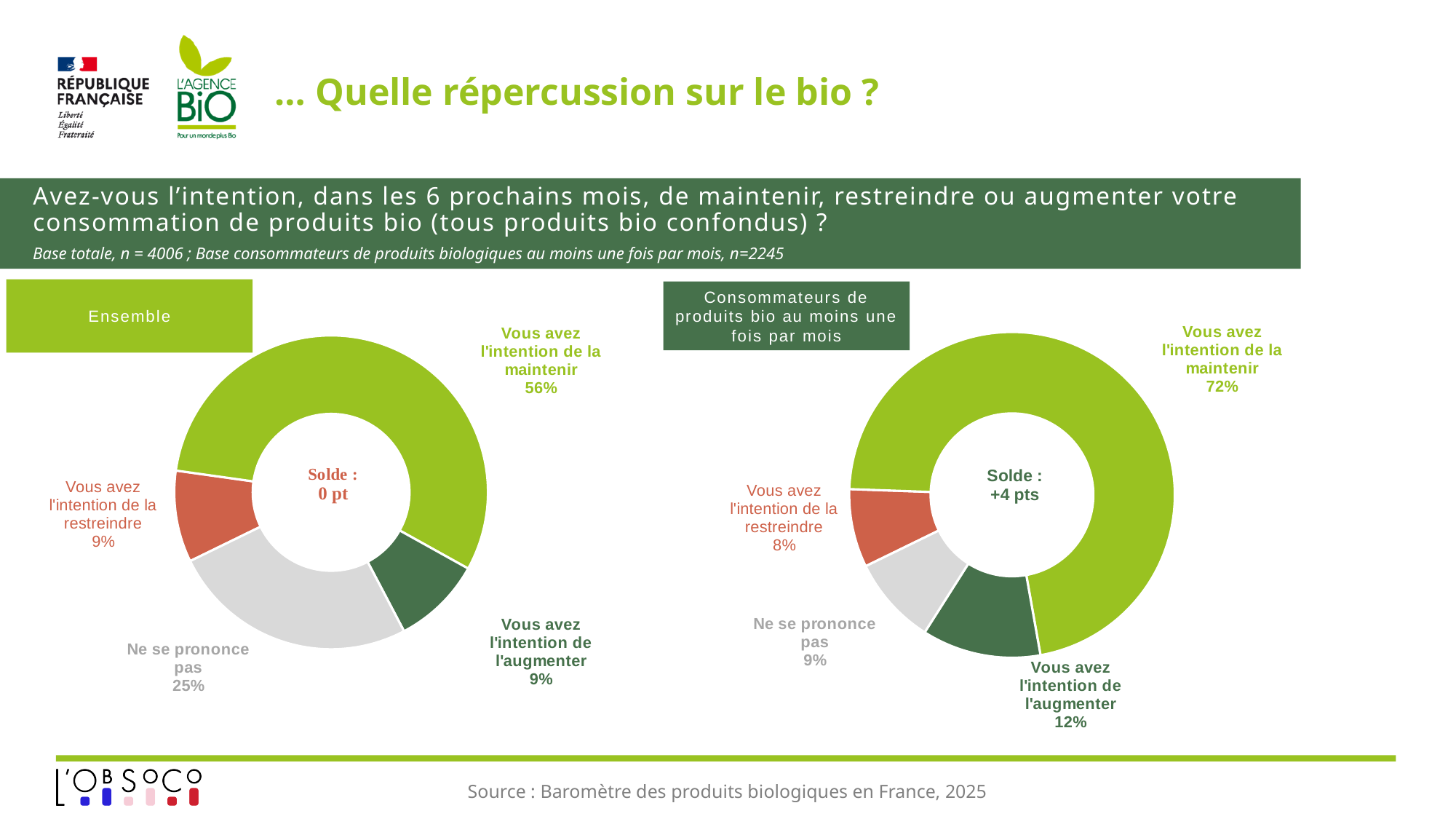
What 'Solde' value is shown in the centre of the 'Ensemble' chart? 0 pt How many categories does each donut chart show? 4 What 'Solde' value is shown in the centre of the 'Consommateurs de produits bio au moins une fois par mois' chart? +4 pts In the 'Ensemble' chart, what share of respondents answered 'Ne se prononce pas'? 25% In the 'Ensemble' chart, which is larger: the share intending to restrict or the share answering 'Ne se prononce pas'? Ne se prononce pas In the 'Consommateurs de produits bio au moins une fois par mois' chart, which category has the smallest share? Vous avez l'intention de la restreindre In the 'Ensemble' chart, which category has the largest share? Vous avez l'intention de la maintenir In the 'Ensemble' chart, what share of respondents intend to maintain their consumption of organic products? 56% What type of chart is used on this slide? Donut (pie) chart In the 'Consommateurs de produits bio au moins une fois par mois' chart, what share intend to increase their consumption? 12% In the 'Consommateurs de produits bio au moins une fois par mois' chart, what share intend to restrict their consumption? 8% What is the difference between the share intending to maintain consumption in the 'Consommateurs de produits bio au moins une fois par mois' chart and in the 'Ensemble' chart? 16 percentage points